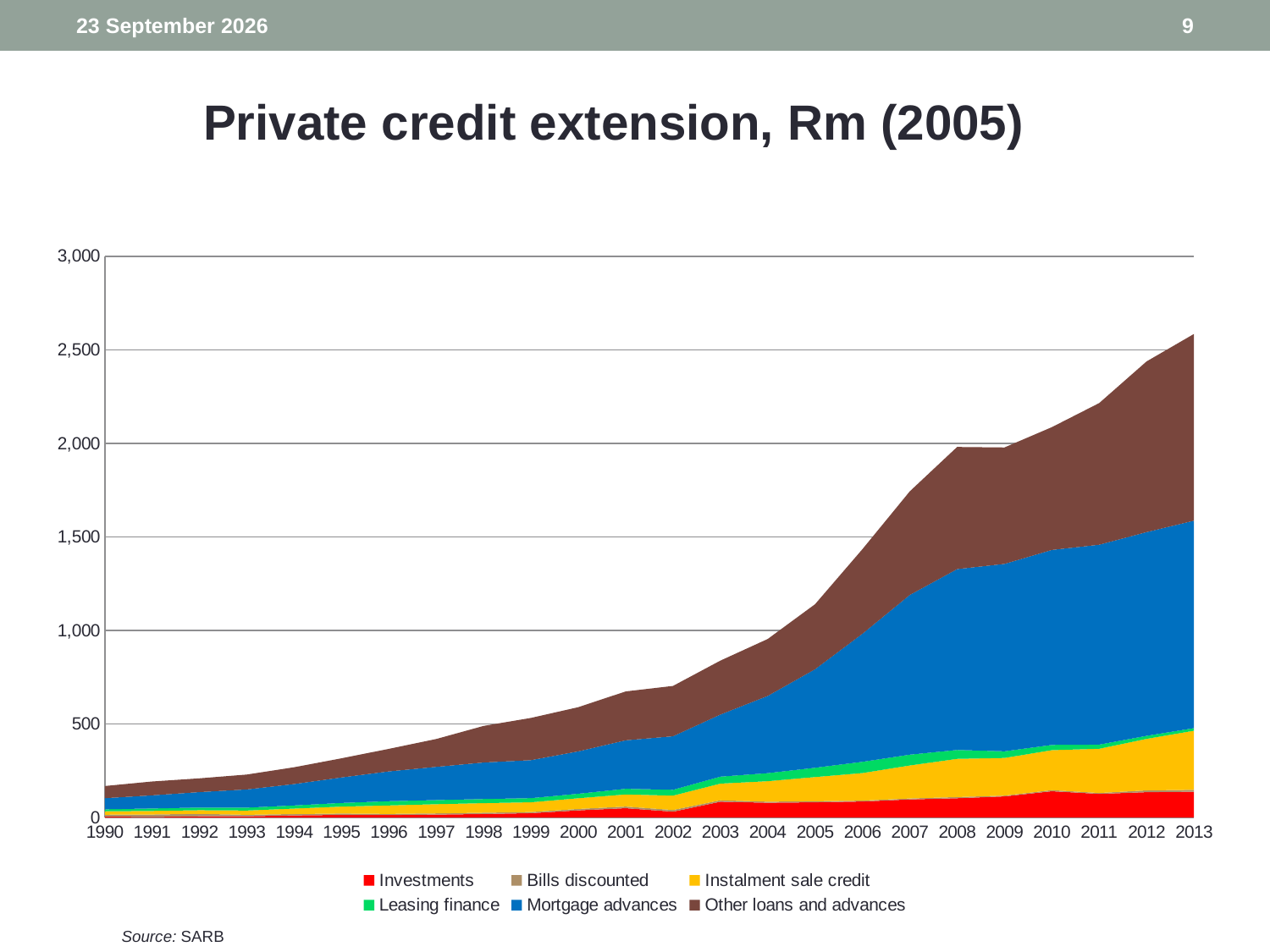
What kind of chart is shown on the slide? Stacked area chart Is the total value for 2005 greater or less than 1,000? greater How many years are shown along the x axis? 24 Which year has the highest total private credit extension? 2013 Which year has the lowest total private credit extension? 1990 What is the title of the chart? Private credit extension, Rm (2005) Is the total value for 1990 greater or less than 500? less Is the total value for 2002 greater or less than 1,000? less Does the total private credit extension rise or fall from 1990 to 2013? rise Which series is shown in blue in the legend? Mortgage advances How many series does the legend list? 6